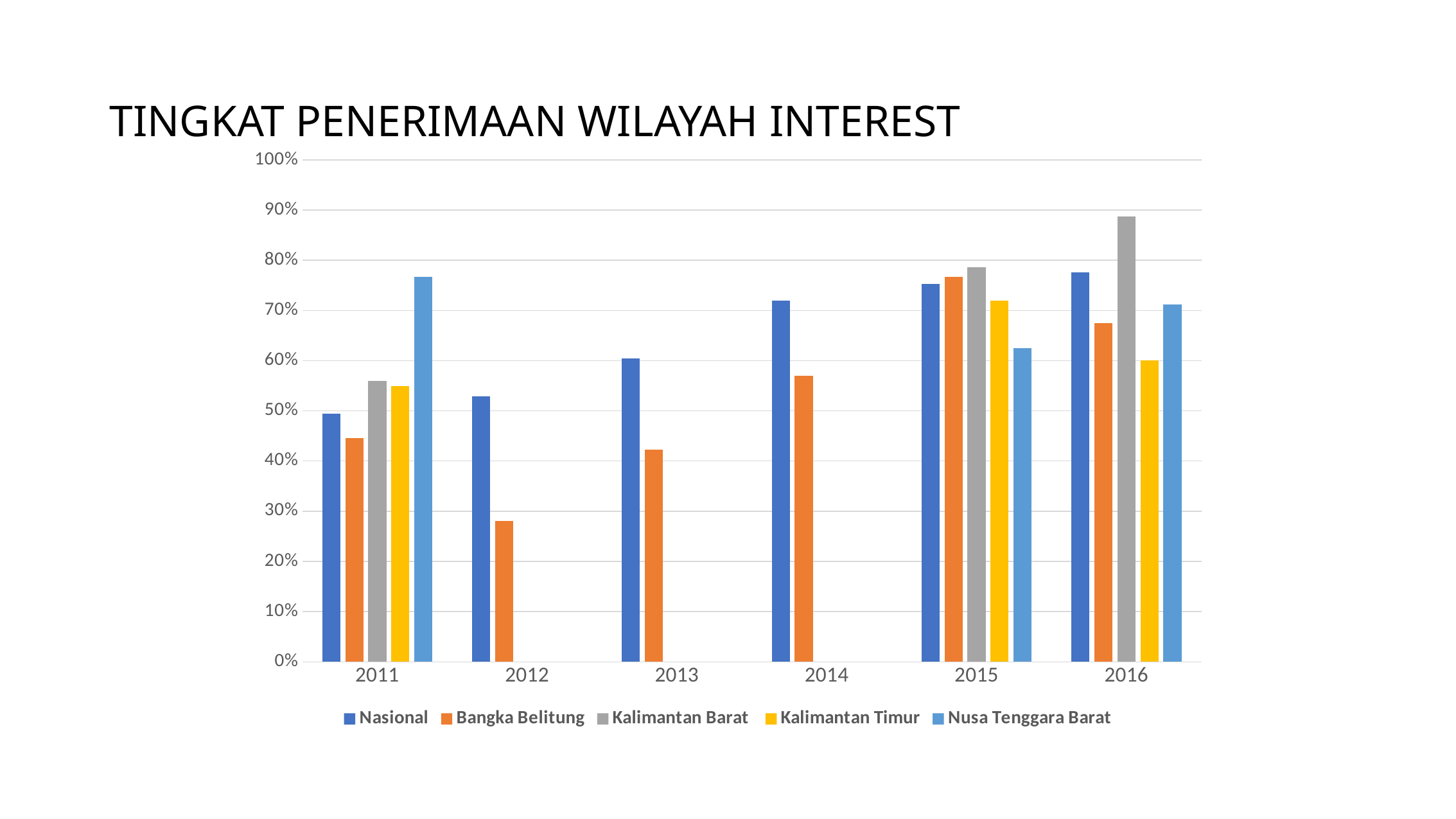
What is the title of the chart? TINGKAT PENERIMAAN WILAYAH INTEREST How many series does the legend list? 5 Is the value for Bangka Belitung in 2012 greater or less than 30%? less In which year is the Kalimantan Barat bar the highest? 2016 How many years are shown on the x axis? 6 Is the value for Nasional in 2013 greater or less than 50%? greater In 2011, which is larger: Nasional or Bangka Belitung? Nasional In 2016, which is larger: Kalimantan Barat or Kalimantan Timur? Kalimantan Barat Do the Nasional values rise or fall from 2011 to 2016? rise Is the value for Nusa Tenggara Barat in 2011 greater or less than 70%? greater What kind of chart is shown on the slide? bar chart In which year is the Bangka Belitung bar the lowest? 2012